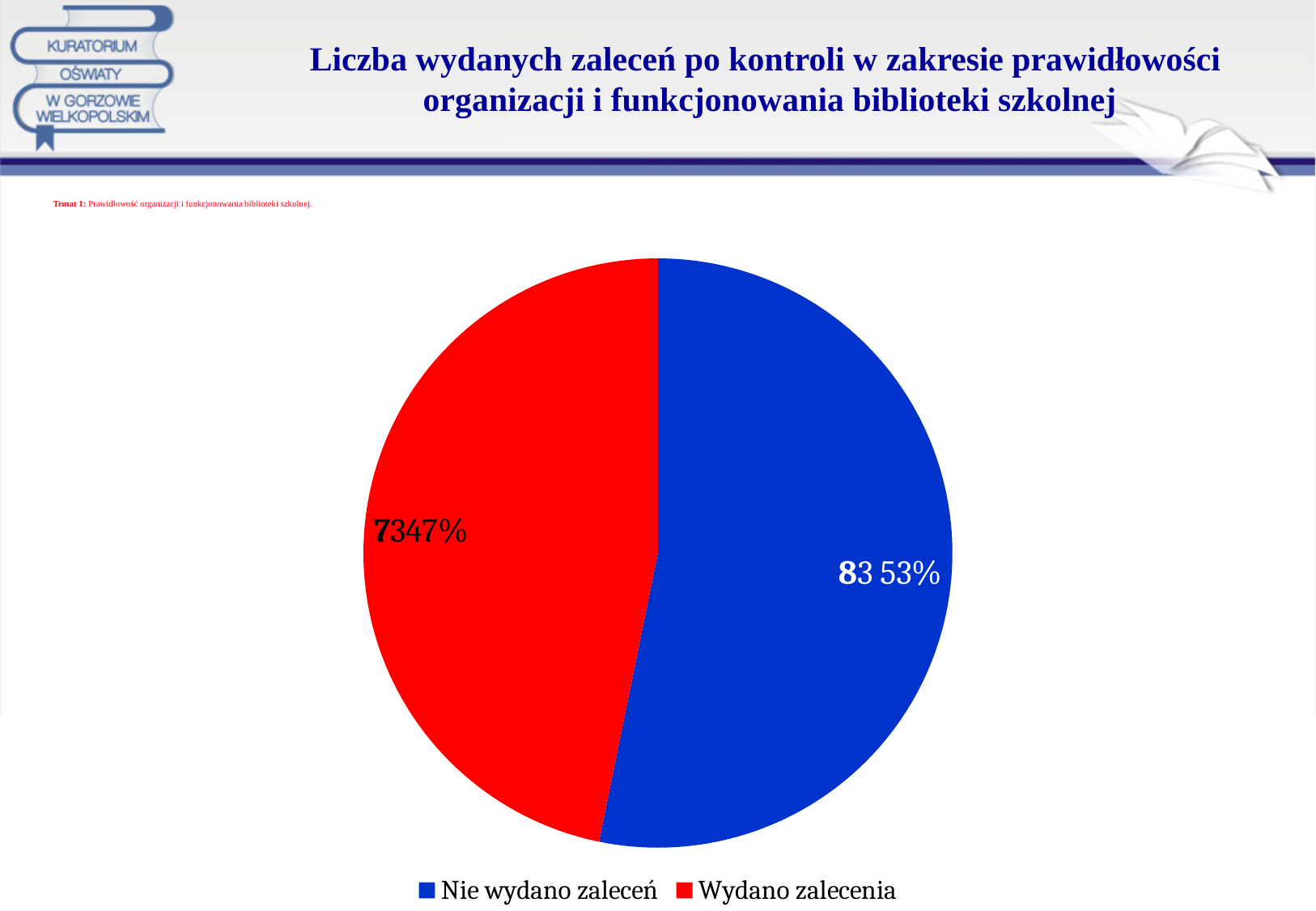
Which category has the smallest slice of the pie? Wydano zalecenia What is the number shown for 'Nie wydano zaleceń'? 83 What percentage share does the 'Wydano zalecenia' slice have? 47% Which is larger, the value for 'Nie wydano zaleceń' or for 'Wydano zalecenia'? Nie wydano zaleceń What is the difference between the number for 'Nie wydano zaleceń' and the number for 'Wydano zalecenia'? 10 What is the number shown for 'Wydano zalecenia'? 73 What colour is the 'Wydano zalecenia' slice? red What kind of chart is shown on the slide? pie chart Which category has the largest slice of the pie? Nie wydano zaleceń How many entries does the legend list? 2 What percentage share does the 'Nie wydano zaleceń' slice have? 53% How many slices does the pie chart have? 2